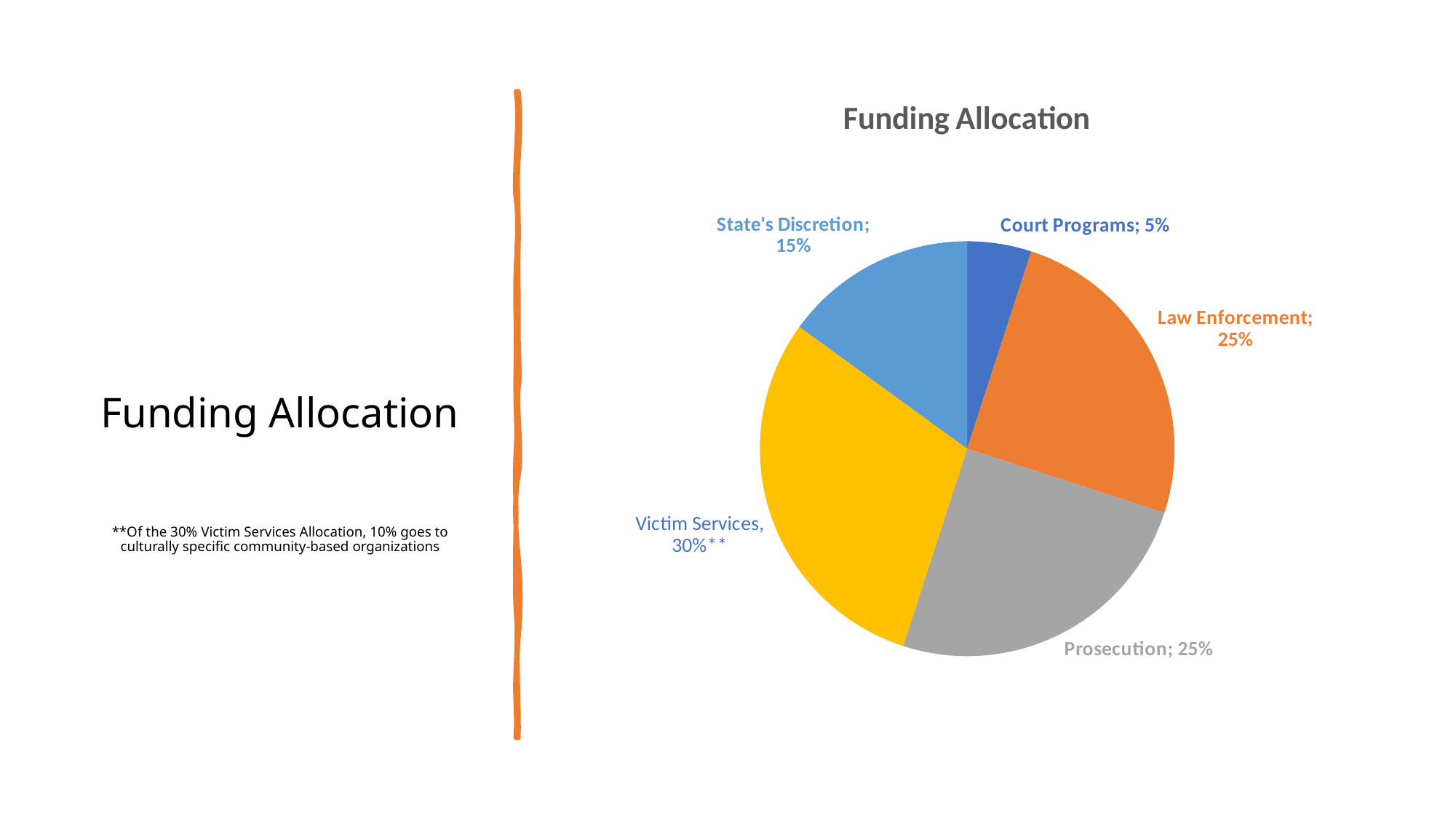
What colour is the Victim Services slice? Yellow What percentage of funding is allocated to Court Programs? 5% What is the difference between the Victim Services share and the State's Discretion share? 15% What kind of chart is shown on the slide? Pie chart What percentage of funding is allocated to State's Discretion? 15% Which is larger, the share for Law Enforcement or the share for State's Discretion? Law Enforcement What percentage of funding is allocated to Victim Services? 30% Which category receives the smallest share of funding? Court Programs How many categories are shown in the pie chart? 5 What percentage of funding is allocated to Law Enforcement? 25% Which category receives the largest share of funding? Victim Services What is the title of the chart? Funding Allocation